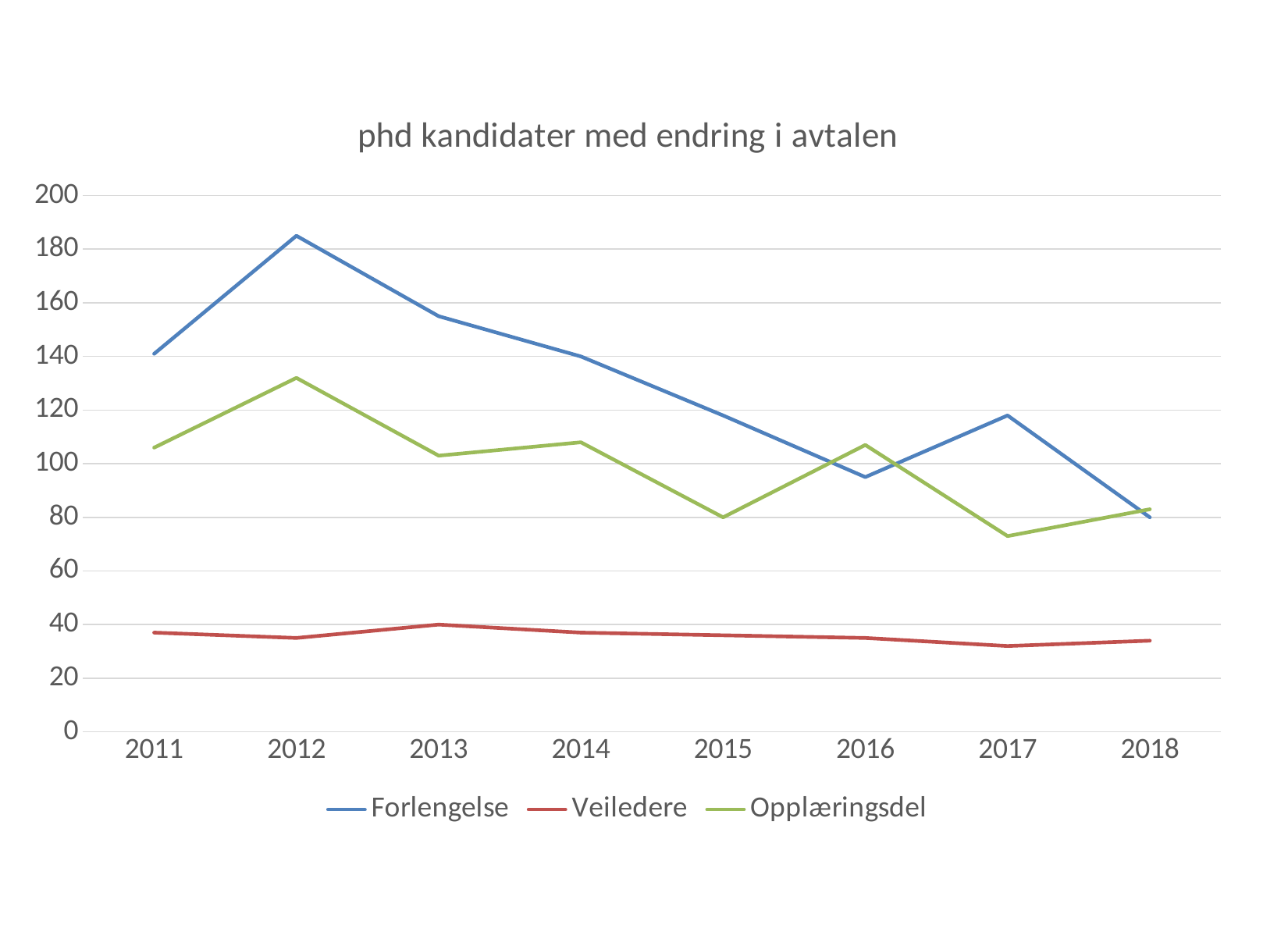
In 2016, which series has the larger value, Forlengelse or Opplæringsdel? Opplæringsdel What kind of chart is shown on the slide? line chart Does the Forlengelse series rise or fall from 2012 to 2016? fall Is the value for Opplæringsdel in 2012 greater or less than 120? greater How many series does the legend list? 3 What is the title of the chart? phd kandidater med endring i avtalen In which year does the Forlengelse series reach its highest value? 2012 Is the value for Forlengelse in 2016 greater or less than 100? less In which year does the Opplæringsdel series reach its lowest value? 2017 Is the value for Forlengelse in 2012 greater or less than 160? greater In which year does the Forlengelse series reach its lowest value? 2018 How many years are shown on the x axis? 8